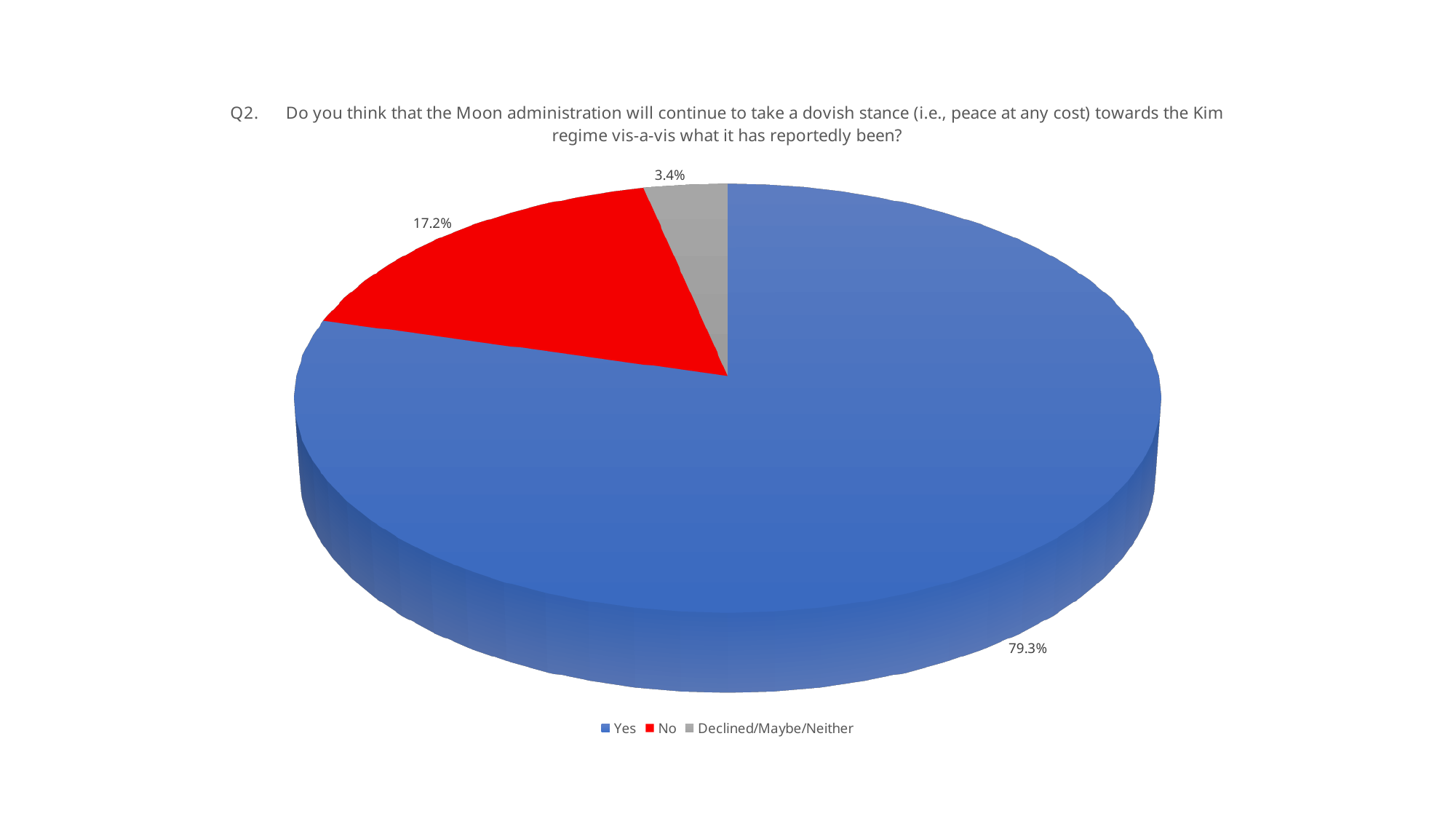
Which is larger, the share for No or the share for Declined/Maybe/Neither? No What is the difference in percentage points between the No and Declined/Maybe/Neither shares? 13.8 What percentage of respondents are in the Declined/Maybe/Neither category? 3.4% What percentage of respondents answered Yes? 79.3% What kind of chart is shown on the slide? pie chart What is the difference in percentage points between the Yes and No shares? 62.1 What percentage of respondents answered No? 17.2% What colour is the slice for Yes? blue Which response has the largest share of the pie? Yes What colour is the slice for No? red How many categories does the legend list? 3 Which response has the smallest share of the pie? Declined/Maybe/Neither